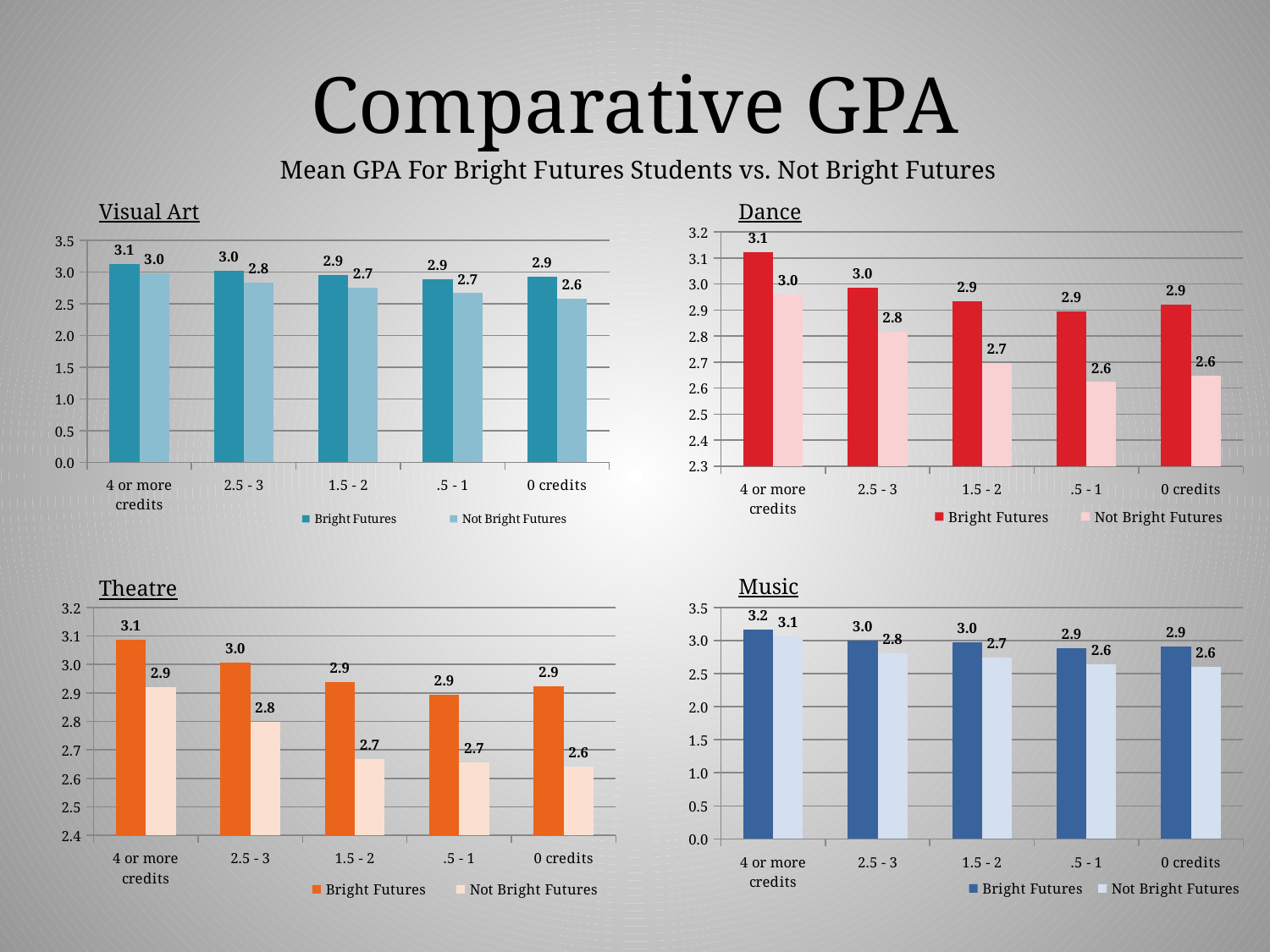
What is the subtitle shown under the slide title 'Comparative GPA'? Mean GPA For Bright Futures Students vs. Not Bright Futures In the Theatre chart, do the Not Bright Futures values generally rise or fall from 4 or more credits to 0 credits? Fall In the Dance chart, which is larger for 2.5 - 3 credits: Bright Futures or Not Bright Futures? Bright Futures In the Dance chart, what is the value for Not Bright Futures students with .5 - 1 credits? 2.6 What type of chart is the Music chart? Bar chart In the Theatre chart, which credit category has the highest Bright Futures GPA? 4 or more credits How many credit categories are shown on the x axis of the Visual Art chart? 5 How many series does the legend of the Dance chart list? 2 In the Music chart, what is the difference between the Bright Futures and Not Bright Futures values for 1.5 - 2 credits? 0.3 In the Theatre chart, what is the value for Not Bright Futures students with 0 credits? 2.6 In the Music chart, what is the value for Bright Futures students with 4 or more credits? 3.2 In the Visual Art chart, what is the mean GPA for Bright Futures students with 4 or more credits? 3.1